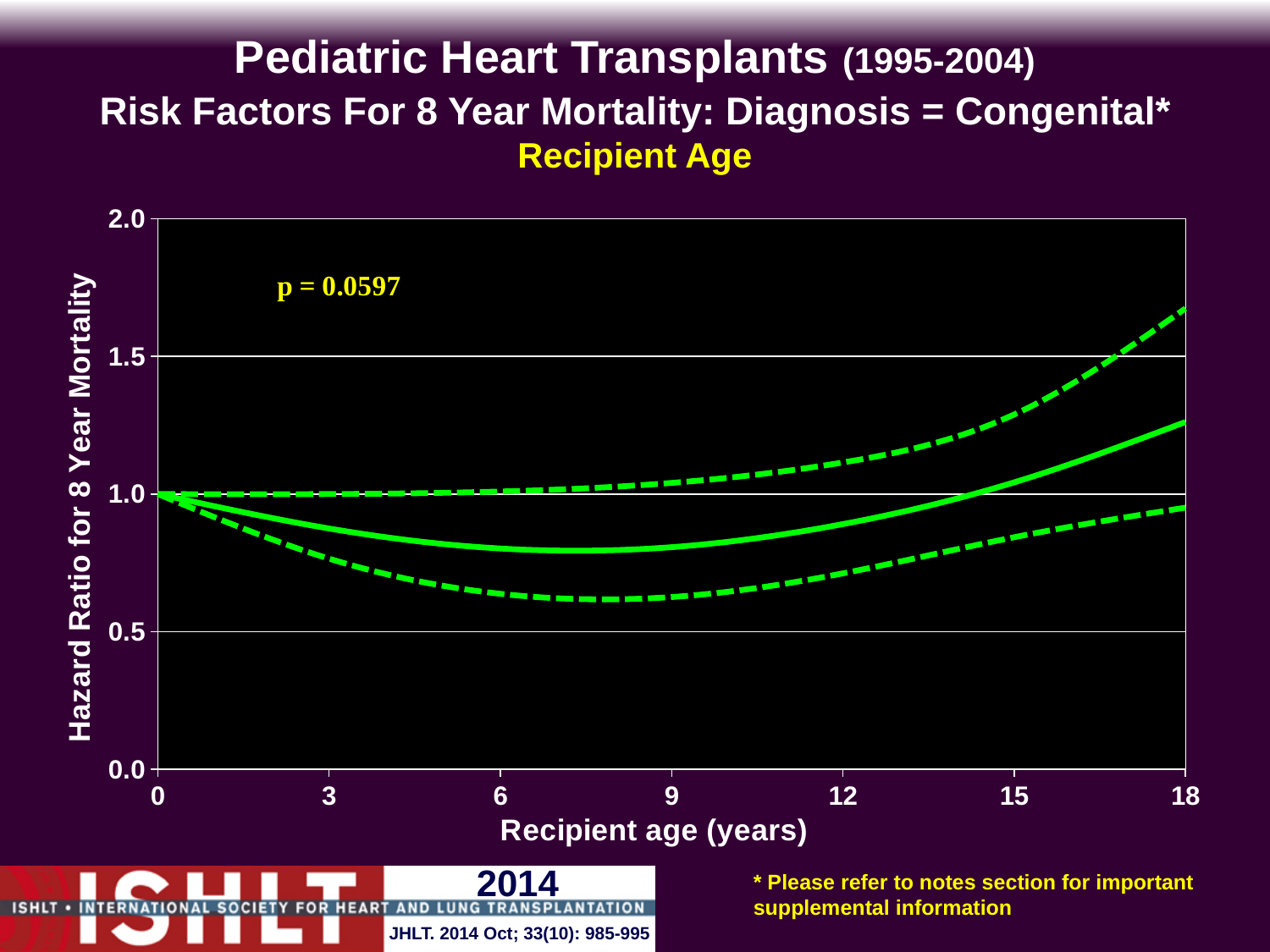
What is the p-value printed on the chart? p = 0.0597 What kind of chart is shown on the slide? line chart What is the hazard ratio of the solid line at recipient age 0? 1.0 Is the value of the lower dashed line at recipient age 9 greater or less than 0.5? greater Is the value of the solid line at recipient age 6 greater or less than 1.0? less What is the label of the y axis? Hazard Ratio for 8 Year Mortality How many lines are plotted on the chart? 3 Is the value of the solid line at recipient age 18 greater or less than 1.0? greater Does the solid line rise or fall between recipient age 9 and recipient age 18? rise Does the solid line rise or fall between recipient age 0 and recipient age 6? fall